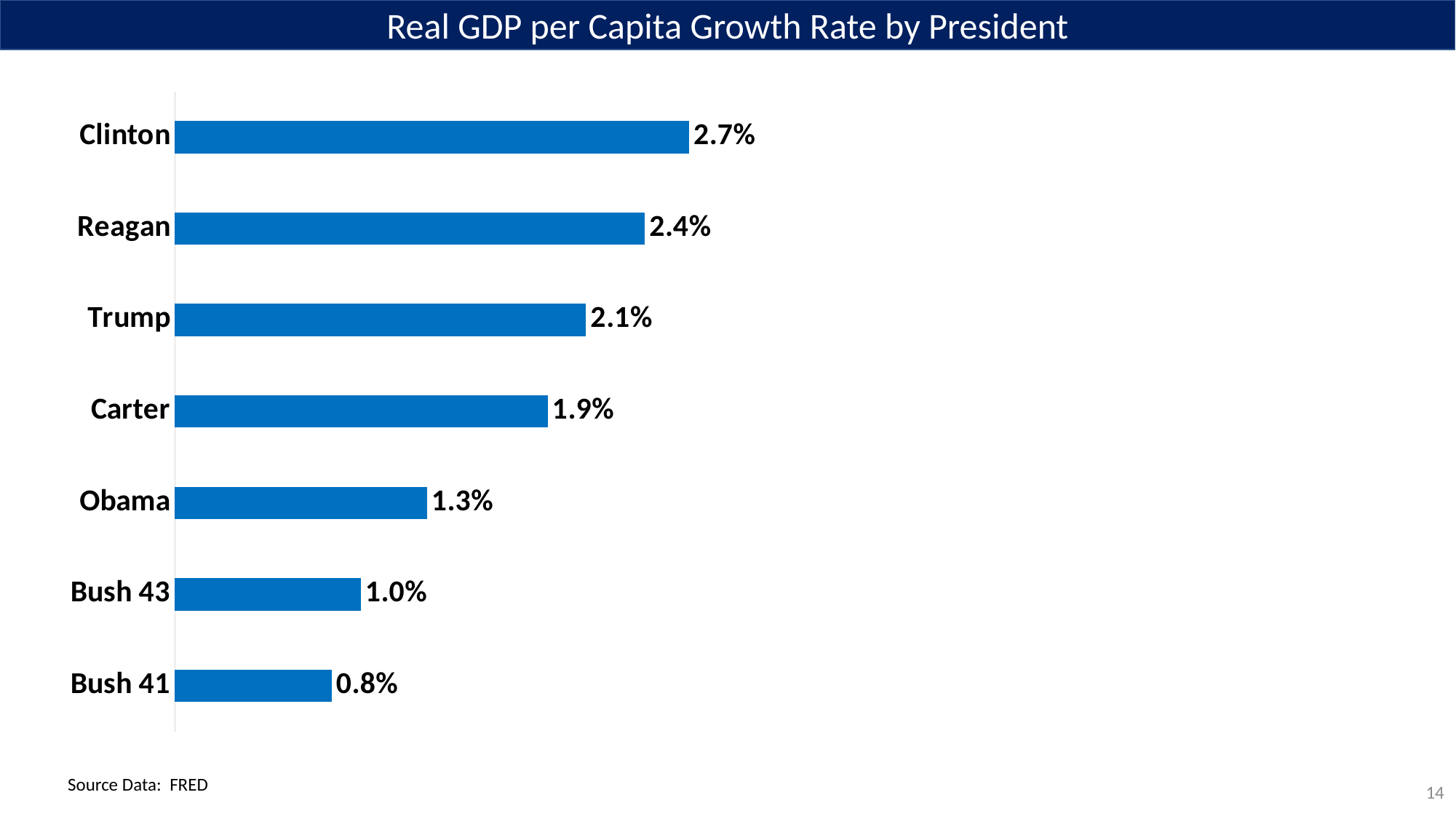
What is the real GDP per capita growth rate shown for Clinton? 2.7% What is the title of the chart? Real GDP per Capita Growth Rate by President What is the real GDP per capita growth rate shown for Obama? 1.3% Which president has the highest real GDP per capita growth rate on the chart? Clinton What is the source of the data shown on the slide? FRED What is the difference between the growth rates for Reagan and Trump? 0.3% What is the real GDP per capita growth rate shown for Bush 41? 0.8% What kind of chart is shown on the slide? Bar chart How many presidents are shown on the chart? 7 Which has a higher growth rate, Carter or Obama? Carter Which president has the lowest real GDP per capita growth rate on the chart? Bush 41 What is the difference between the growth rates for Clinton and Bush 43? 1.7%